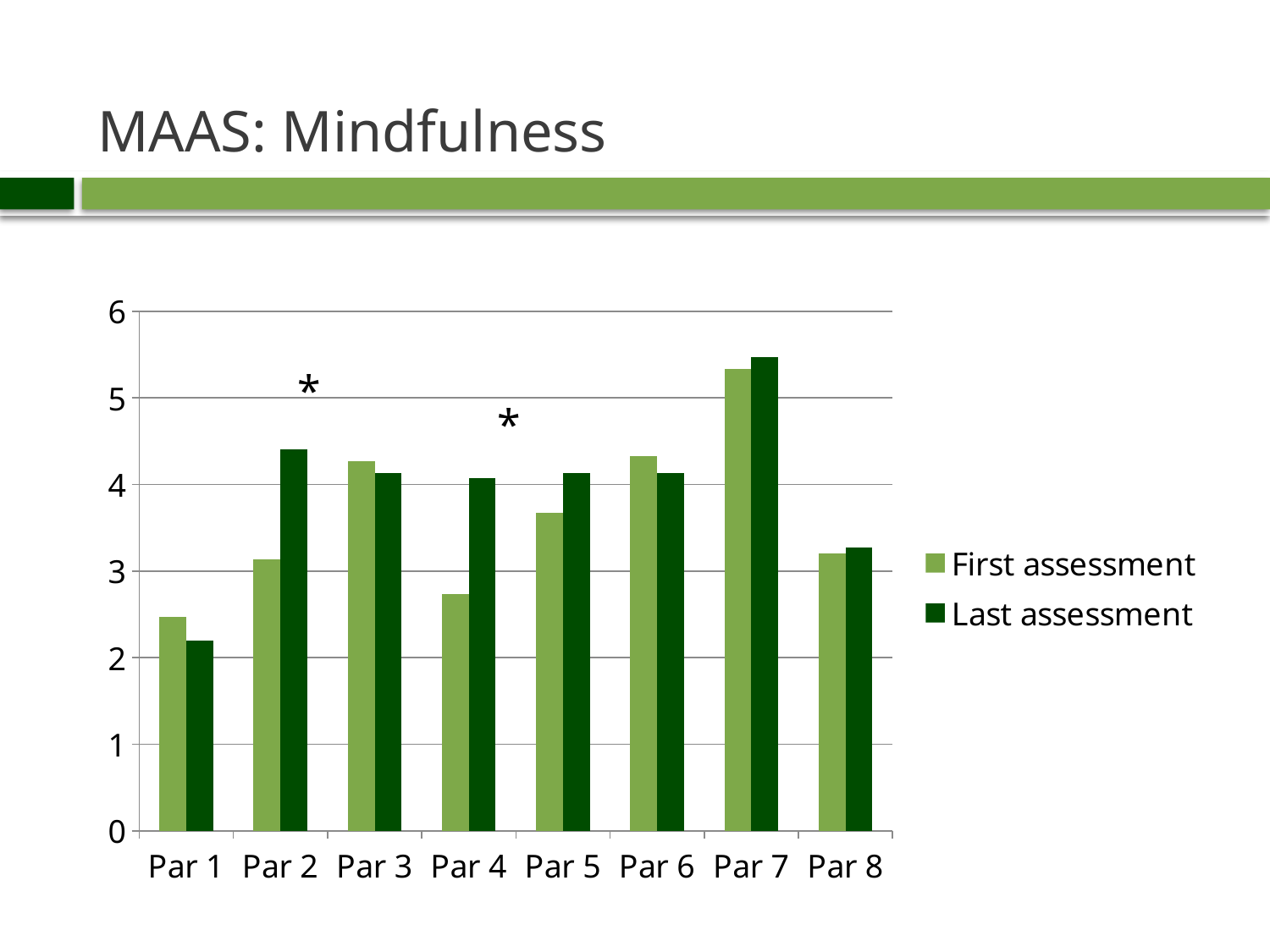
For Par 1, which is larger: the First assessment or the Last assessment value? First assessment Is the First assessment value for Par 7 greater or less than 5? greater Which participant has the lowest First assessment value? Par 1 Which participant has the lowest Last assessment value? Par 1 What kind of chart is shown on the slide? bar chart For Par 2, which is larger: the First assessment or the Last assessment value? Last assessment How many series does the legend list? 2 Is the First assessment value for Par 4 greater or less than 3? less Which participant has the highest First assessment value? Par 7 What is the title of the slide containing the chart? MAAS: Mindfulness Is the Last assessment value for Par 2 greater or less than 4? greater How many participants (categories) are shown on the x axis? 8